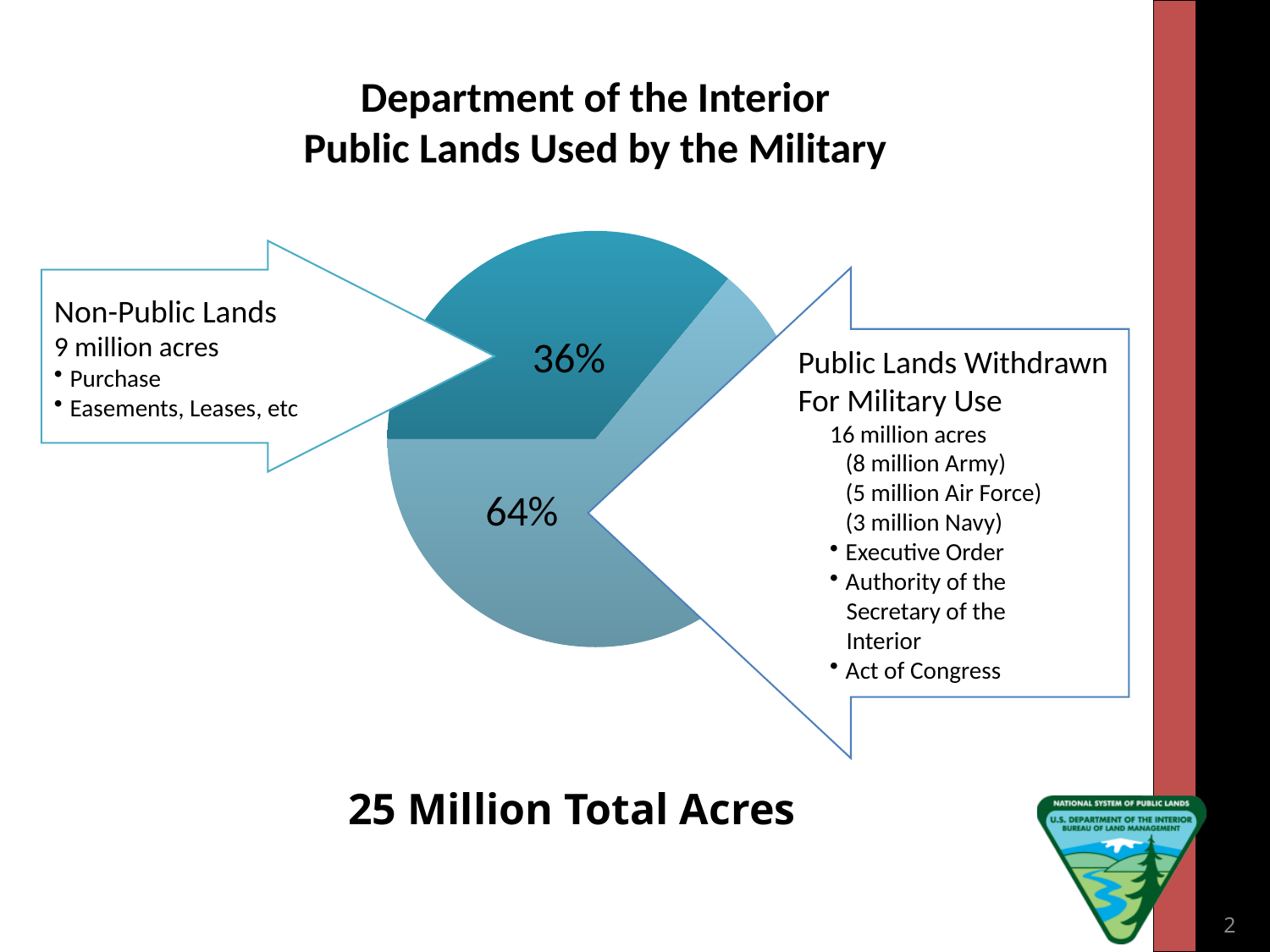
What percentage is shown on the larger slice of the pie chart? 64% How many million acres are Public Lands Withdrawn For Military Use according to the slide? 16 million acres What share of the pie is labelled for Public Lands Withdrawn For Military Use? 64% What kind of chart is shown on the slide? pie chart Which slice is larger: Non-Public Lands or Public Lands Withdrawn For Military Use? Public Lands Withdrawn For Military Use What is the difference in percentage points between the two slices of the pie chart? 28 How many million acres are Non-Public Lands according to the slide? 9 million acres What percentage is shown on the smaller slice of the pie chart? 36% How many slices does the pie chart have? 2 What is the total number of acres stated below the pie chart? 25 Million Total Acres What share of the pie is labelled for Non-Public Lands? 36% Which category has the smallest share of the pie? Non-Public Lands